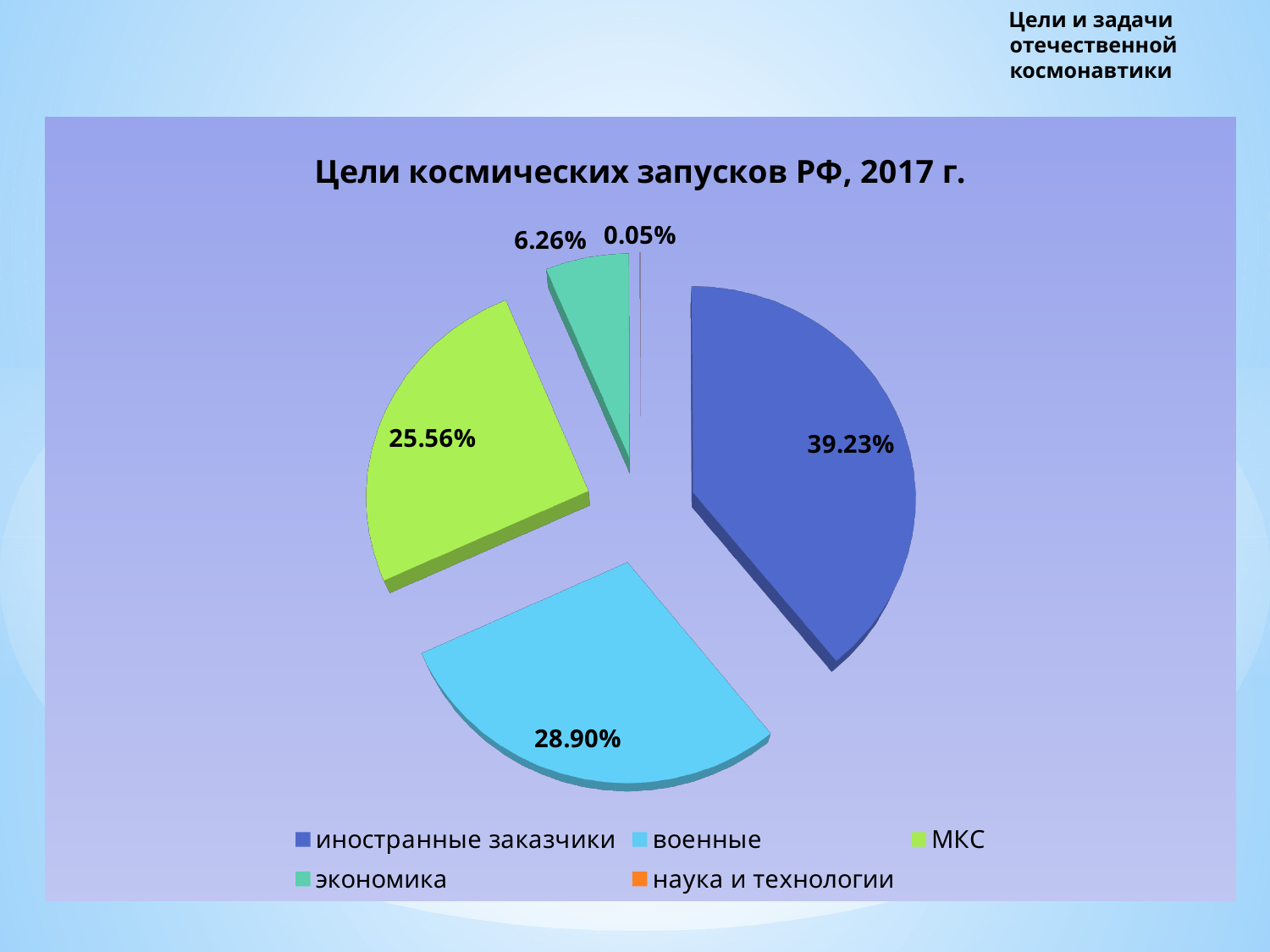
What share of the pie does "МКС" have? 25.56% What type of chart is shown on the slide? pie chart How many categories does the legend list? 5 Which category has the largest share of the pie? иностранные заказчики What share of the pie does "экономика" have? 6.26% Which category has the smallest share of the pie? наука и технологии What share of the pie does "иностранные заказчики" have? 39.23% What share of the pie does "военные" have? 28.90% What is the title of the chart? Цели космических запусков РФ, 2017 г. What is the difference between the shares of "иностранные заказчики" and "военные"? 10.33% What share of the pie does "наука и технологии" have? 0.05% Which is larger, the share of "военные" or the share of "МКС"? военные